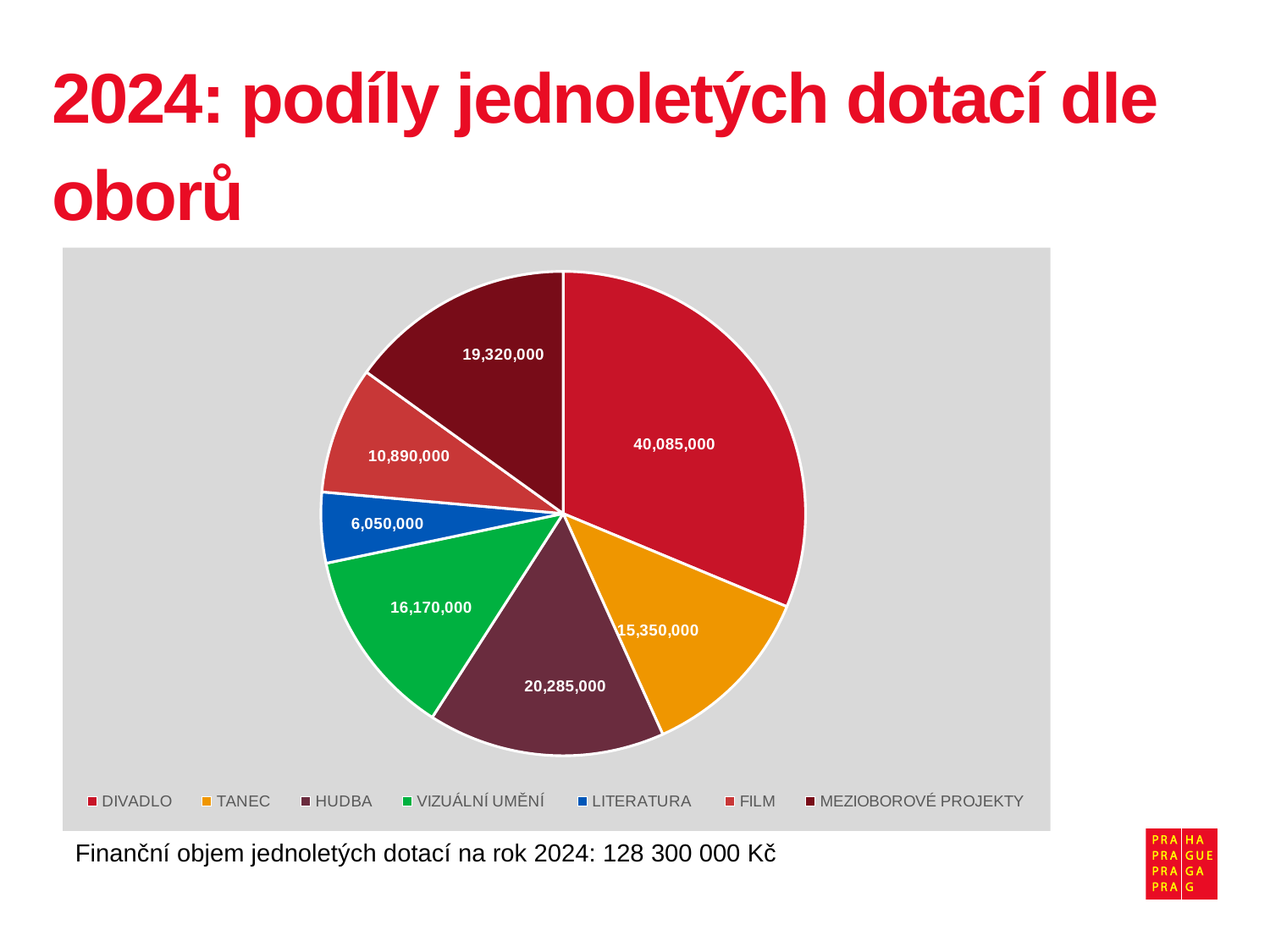
What kind of chart is shown on the slide? Pie chart How many categories does the pie chart show? 7 What is the value for VIZUÁLNÍ UMĚNÍ in the pie chart? 16,170,000 Which category has the smallest slice of the pie chart? LITERATURA What is the value for DIVADLO in the pie chart? 40,085,000 What colour is the FILM slice in the pie chart? Red What is the value for MEZIOBOROVÉ PROJEKTY in the pie chart? 19,320,000 What is the difference between the values for DIVADLO and HUDBA? 19,800,000 What is the value for LITERATURA in the pie chart? 6,050,000 What is the difference between the values for TANEC and LITERATURA? 9,300,000 Which is larger, the value for HUDBA or the value for MEZIOBOROVÉ PROJEKTY? HUDBA Which category has the largest slice of the pie chart? DIVADLO